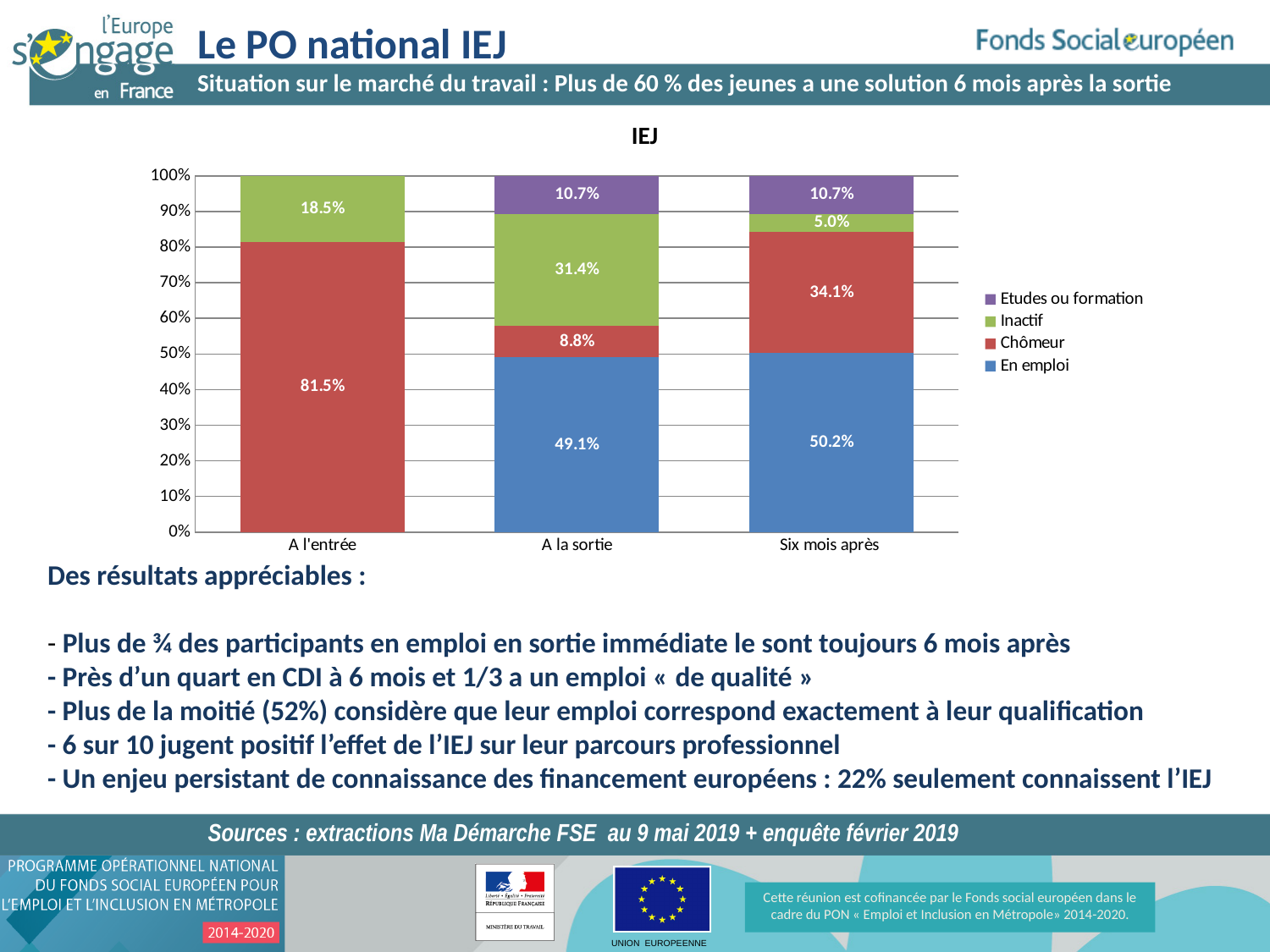
How many series does the legend list? 4 What is the value for En emploi at 'A la sortie'? 49.1% What is the value for Inactif at 'Six mois après'? 5.0% What is the difference between the Chômeur values at 'Six mois après' and 'A la sortie'? 25.3% Which is larger: the Inactif value at 'A la sortie' or at 'A l'entrée'? A la sortie What is the title of the chart? IEJ What type of chart is shown on the slide? stacked bar chart Which category has the highest value for Chômeur? A l'entrée What is the value for Etudes ou formation at 'Six mois après'? 10.7% What is the value for Chômeur at 'A l'entrée'? 81.5% Which category has the lowest value for Inactif? Six mois après How many categories are shown on the x axis? 3